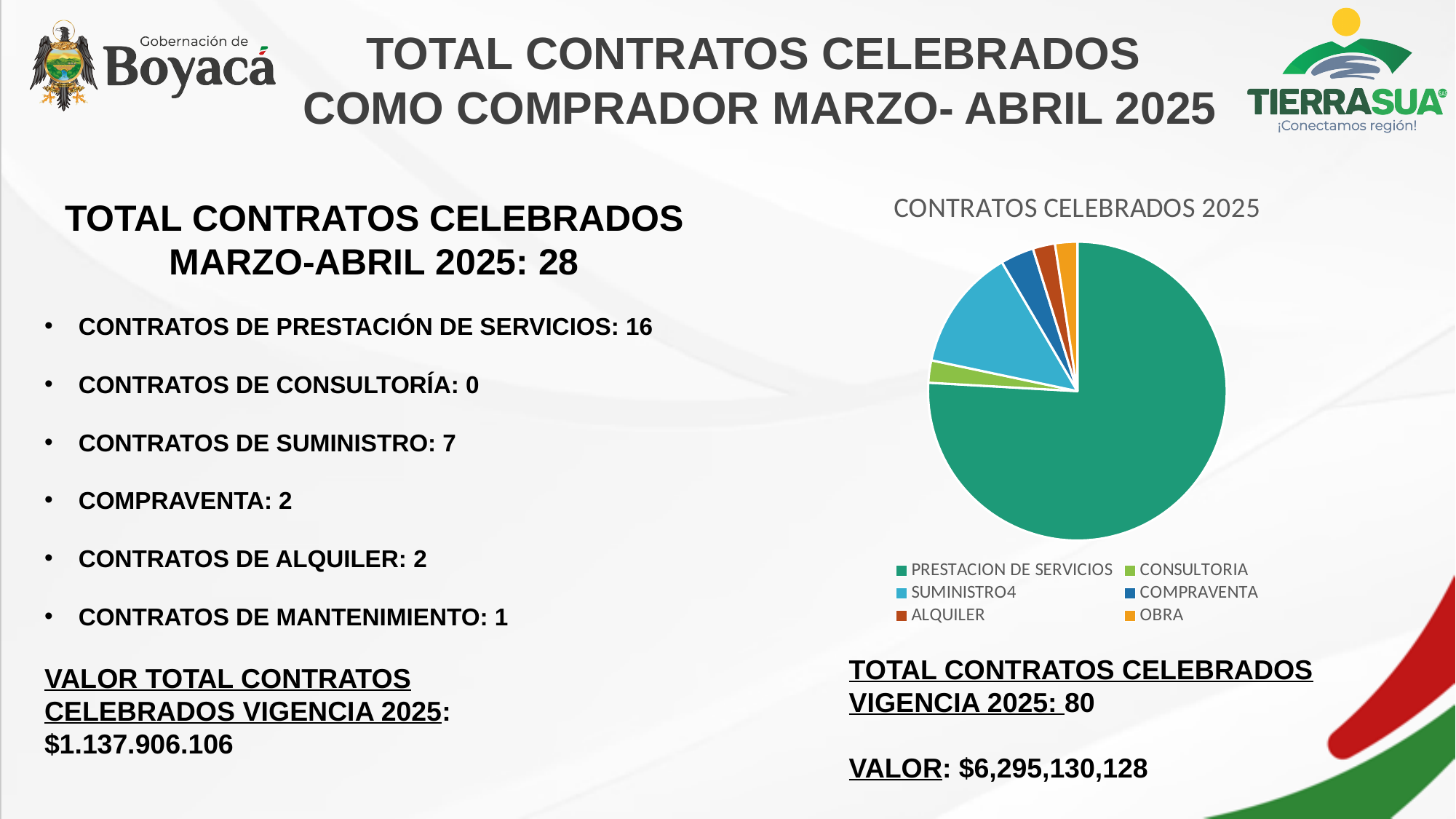
Which category in the pie chart has the second-largest slice? SUMINISTRO4 How many slices does the pie chart have? 6 What kind of chart is shown on the slide? pie chart How many entries does the legend of the pie chart list? 6 What is the title of the pie chart? CONTRATOS CELEBRADOS 2025 Which category has the largest slice in the pie chart? PRESTACION DE SERVICIOS In the pie chart, which slice is larger: SUMINISTRO4 or ALQUILER? SUMINISTRO4 In the pie chart, which slice is larger: SUMINISTRO4 or COMPRAVENTA? SUMINISTRO4 In the pie chart, which slice is larger: PRESTACION DE SERVICIOS or SUMINISTRO4? PRESTACION DE SERVICIOS